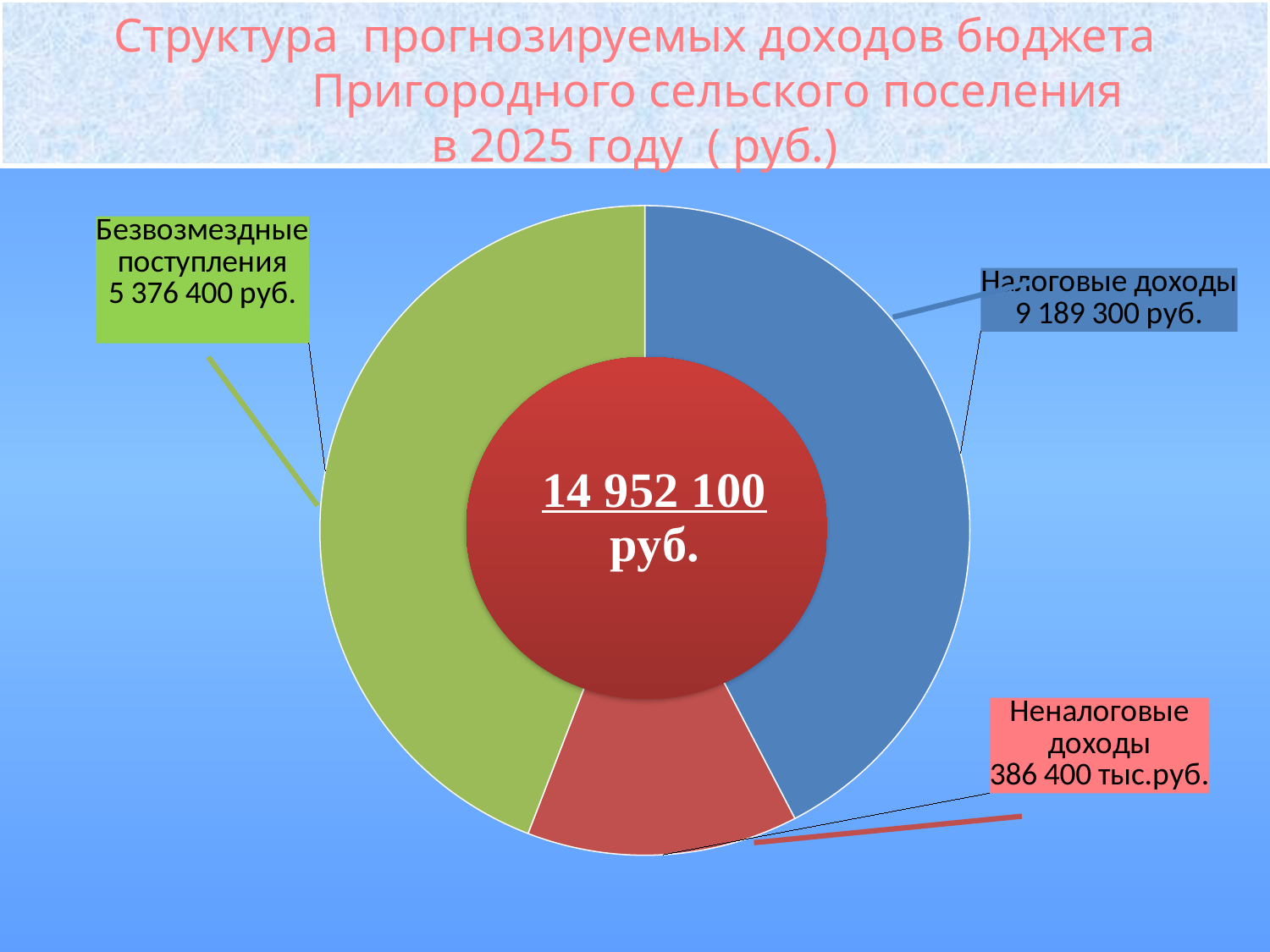
What is the value shown for Безвозмездные поступления? 5 376 400 руб. What is the value shown for Налоговые доходы? 9 189 300 руб. Which is larger, Налоговые доходы or Безвозмездные поступления? Налоговые доходы Which category has the smallest share of the chart? Неналоговые доходы How many categories are shown in the chart? 3 What kind of chart is shown on the slide? Pie (donut) chart What total value is shown in the centre of the chart? 14 952 100 руб. What is the difference between Налоговые доходы and Безвозмездные поступления? 3 812 900 руб. What is the difference between Безвозмездные поступления and Неналоговые доходы? 4 990 000 руб. What is the value shown for Неналоговые доходы? 386 400 тыс.руб. What colour is the segment for Безвозмездные поступления? Green